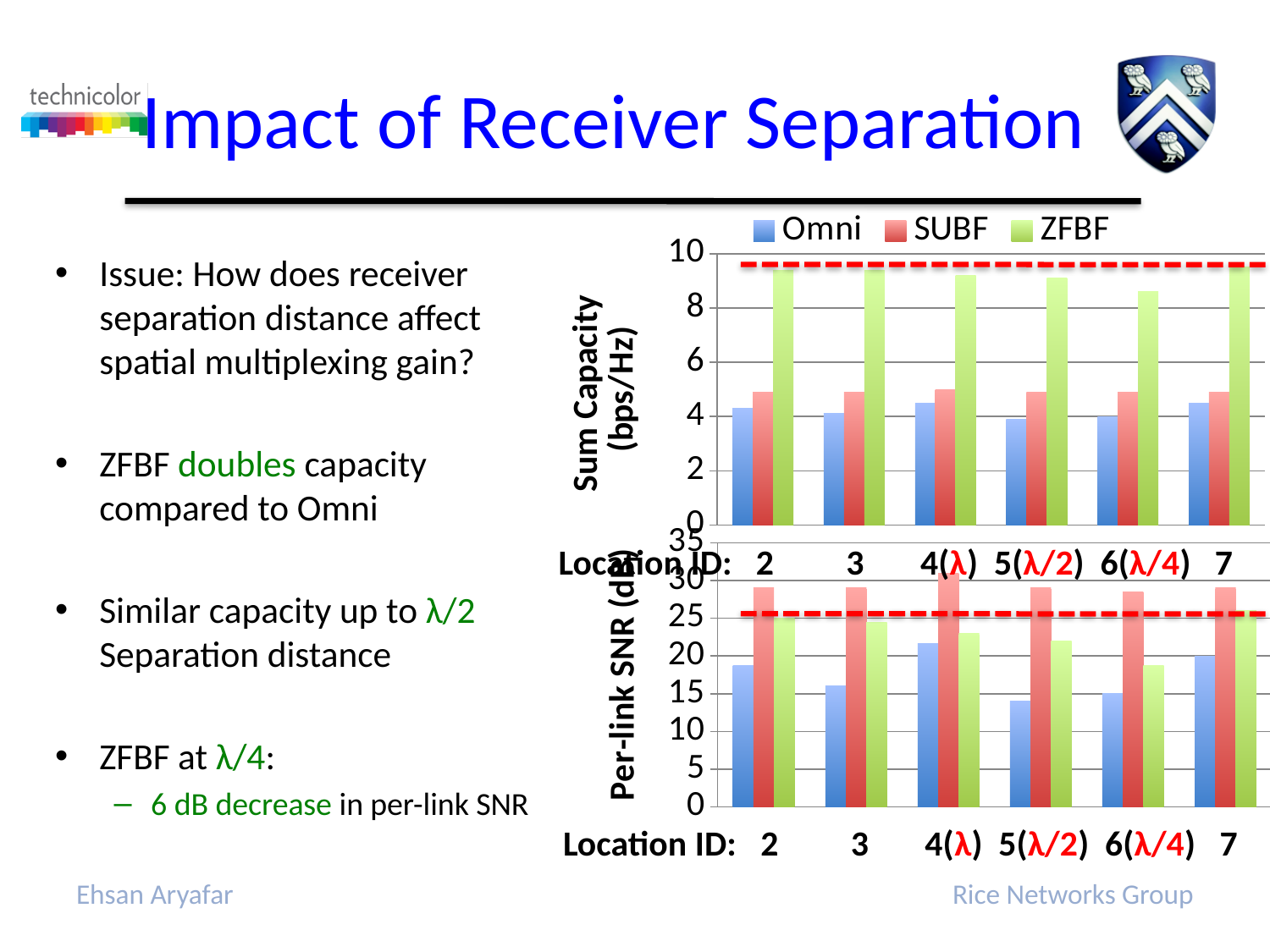
In the top chart (Sum Capacity), how many Location ID categories are shown on the x axis? 6 What is the y-axis title of the bottom chart? Per-link SNR (dB) In the top chart (Sum Capacity), is the ZFBF value at Location ID 2 greater or less than 8? greater In the top chart (Sum Capacity), which series has the highest value at Location ID 7? ZFBF What kind of chart is the top chart (Sum Capacity)? bar chart In the top chart (Sum Capacity), at which Location ID is the ZFBF value lowest? 6(λ/4) How many series does the legend list for the charts? 3 In the bottom chart (Per-link SNR), which series has the highest value at Location ID 4(λ)? SUBF In the bottom chart (Per-link SNR), at Location ID 6(λ/4), which is larger: SUBF or ZFBF? SUBF In the bottom chart (Per-link SNR), at which Location ID is the ZFBF value lowest? 6(λ/4) In the top chart (Sum Capacity), is the Omni value at Location ID 2 greater or less than 6? less In the bottom chart (Per-link SNR), is the Omni value at Location ID 5(λ/2) greater or less than 20? less